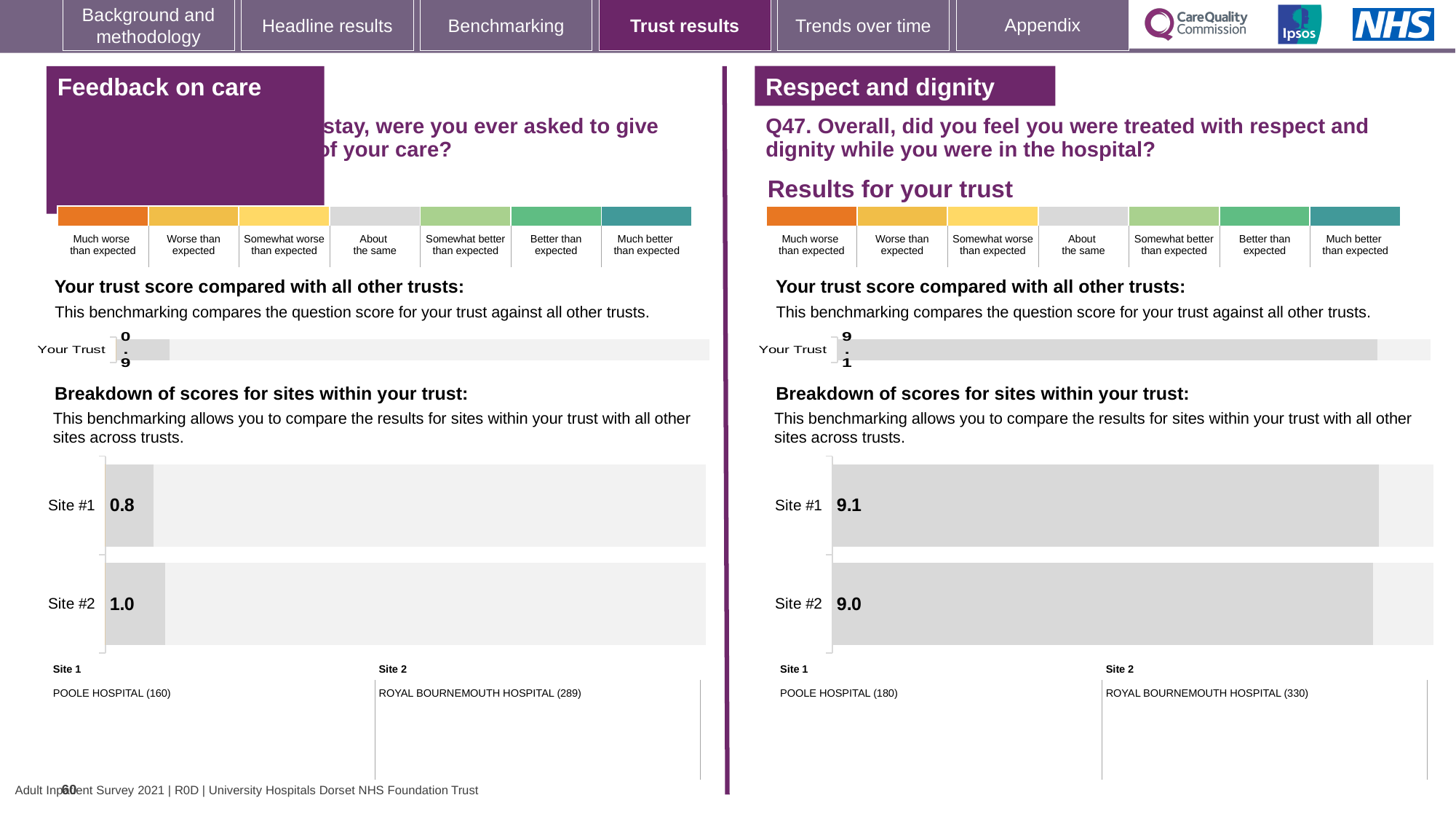
What type of chart is used for the site breakdown on the right-hand 'Respect and dignity' section? Bar chart On the right-hand 'Respect and dignity' site breakdown chart, what is the score for Site #2? 9.0 On the right-hand 'Respect and dignity' site breakdown chart, which site has the lower score? Site #2 On the right-hand 'Respect and dignity' trust chart, what is the score shown for Your Trust? 9.1 On the left-hand 'Feedback on care' site breakdown chart, what is the difference between the Site #2 and Site #1 scores? 0.2 On the right-hand 'Respect and dignity' site breakdown chart, what is the score for Site #1? 9.1 On the left-hand 'Feedback on care' site breakdown chart, which site has the higher score? Site #2 On the right-hand 'Respect and dignity' site breakdown chart, what is the difference between the Site #1 and Site #2 scores? 0.1 How many sites are shown in the left-hand 'Feedback on care' site breakdown chart? 2 On the left-hand 'Feedback on care' site breakdown chart, what is the score for Site #2? 1.0 On the left-hand 'Feedback on care' trust chart, what is the score shown for Your Trust? 0.9 On the left-hand 'Feedback on care' site breakdown chart, what is the score for Site #1? 0.8